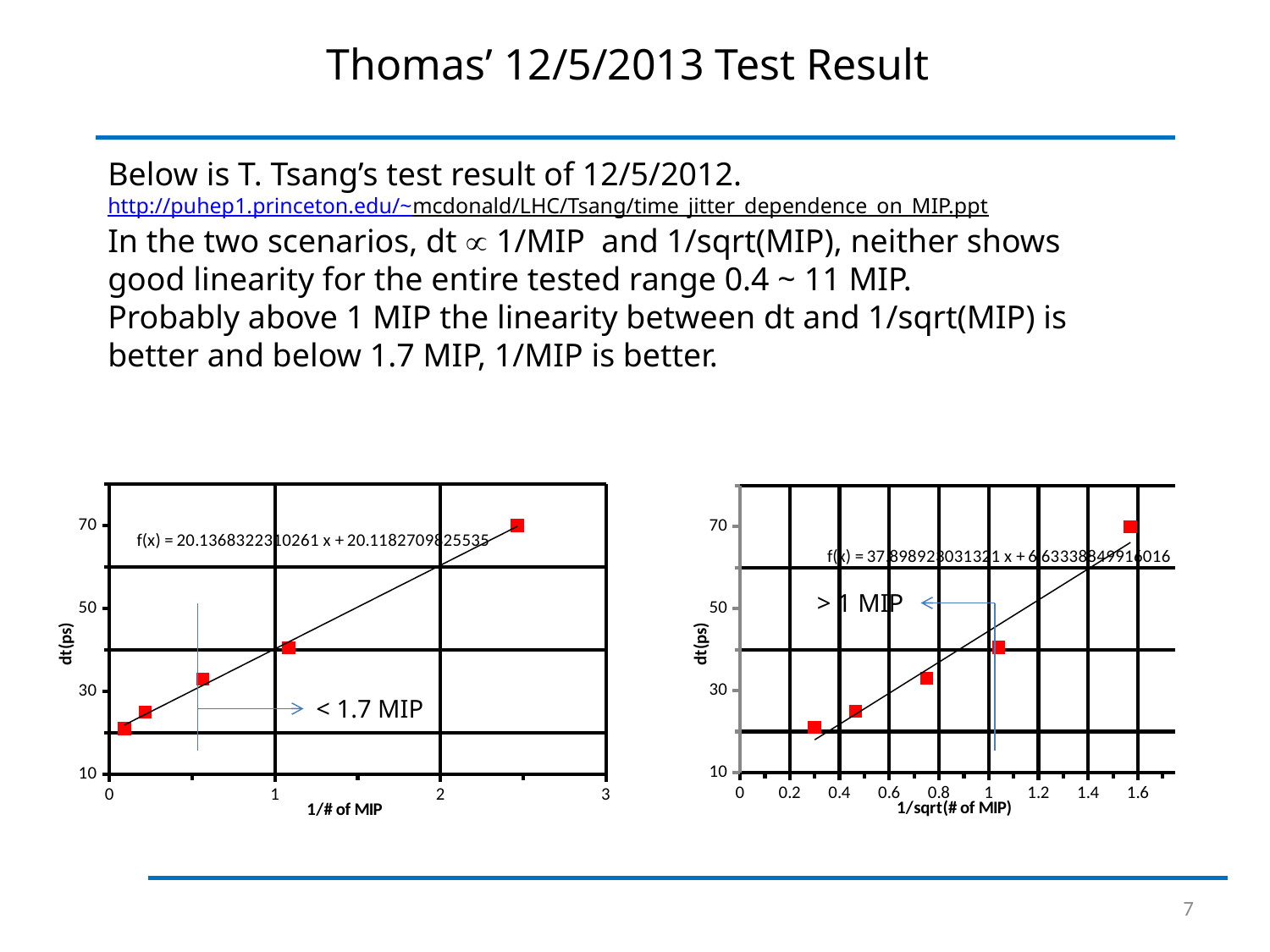
On the left chart (1/# of MIP), is the dt(ps) value of the leftmost point greater or less than 30? less How many data points are plotted on the right chart (1/sqrt(# of MIP))? 5 On the left chart (1/# of MIP), is the dt(ps) value of the rightmost point greater or less than 50? greater On the right chart (1/sqrt(# of MIP)), is the dt(ps) value of the point near x = 1 greater or less than 50? less What is the y-axis label on the left chart? dt(ps) On the left chart (1/# of MIP), do the dt(ps) values rise or fall as 1/# of MIP increases? rise How many data points are plotted on the left chart (1/# of MIP)? 5 What is the x-axis label on the right chart? 1/sqrt(# of MIP) What kind of chart is the left chart with x axis '1/# of MIP'? scatter chart On the right chart (1/sqrt(# of MIP)), do the dt(ps) values rise or fall as 1/sqrt(# of MIP) increases? rise